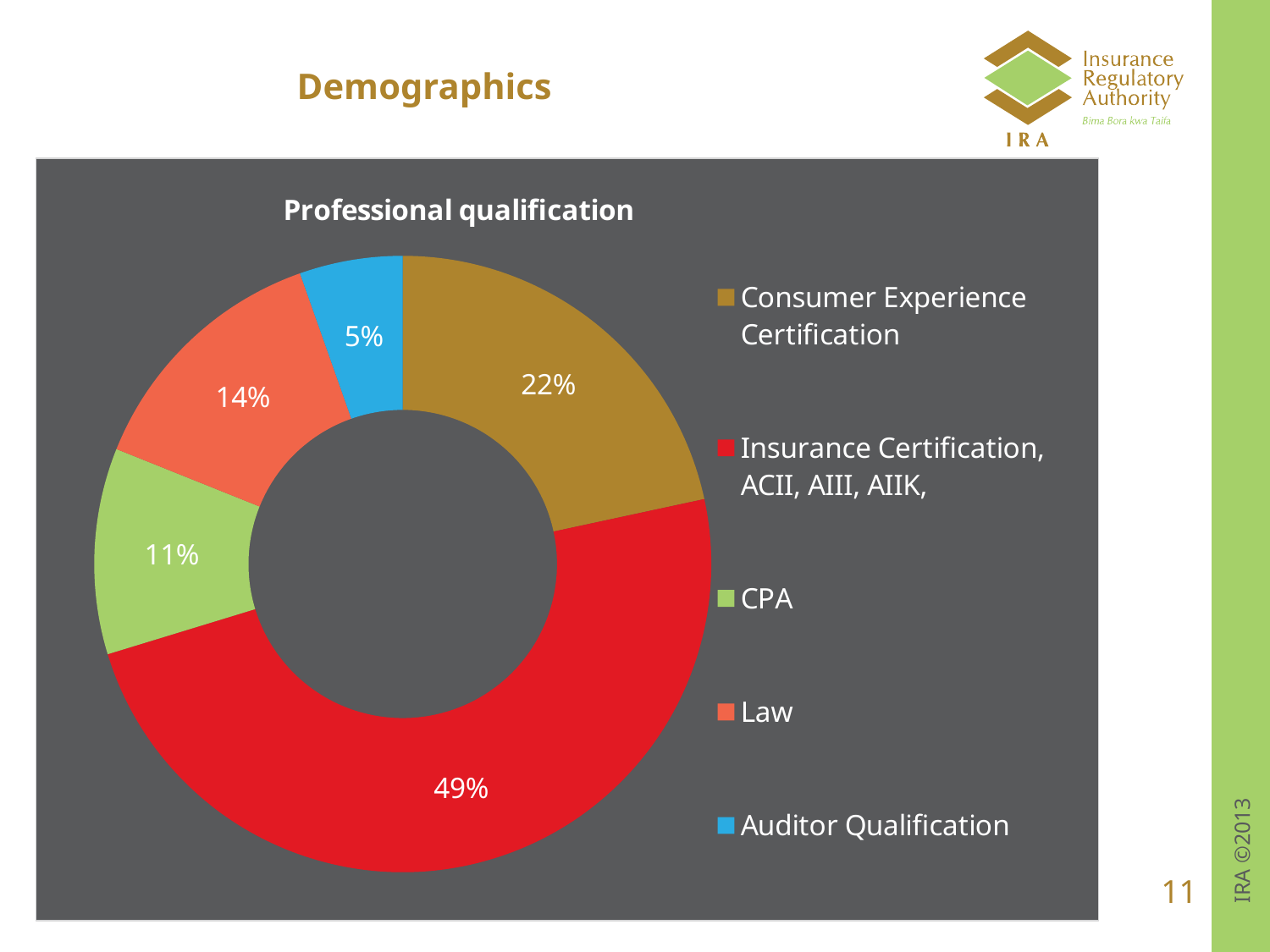
What percentage is shown for CPA? 11% How many categories does the legend list? 5 What type of chart is shown on the slide? Doughnut chart What percentage is shown for Auditor Qualification? 5% What percentage of the chart is Insurance Certification, ACII, AIII, AIIK? 49% What is the title of the chart? Professional qualification What percentage is shown for Law? 14% What is the difference in percentage points between Insurance Certification, ACII, AIII, AIIK and Consumer Experience Certification? 27 percentage points Which category has the largest share of the chart? Insurance Certification, ACII, AIII, AIIK What percentage is shown for Consumer Experience Certification? 22% Which category has the smallest share of the chart? Auditor Qualification Which is larger, the share for Law or the share for CPA? Law